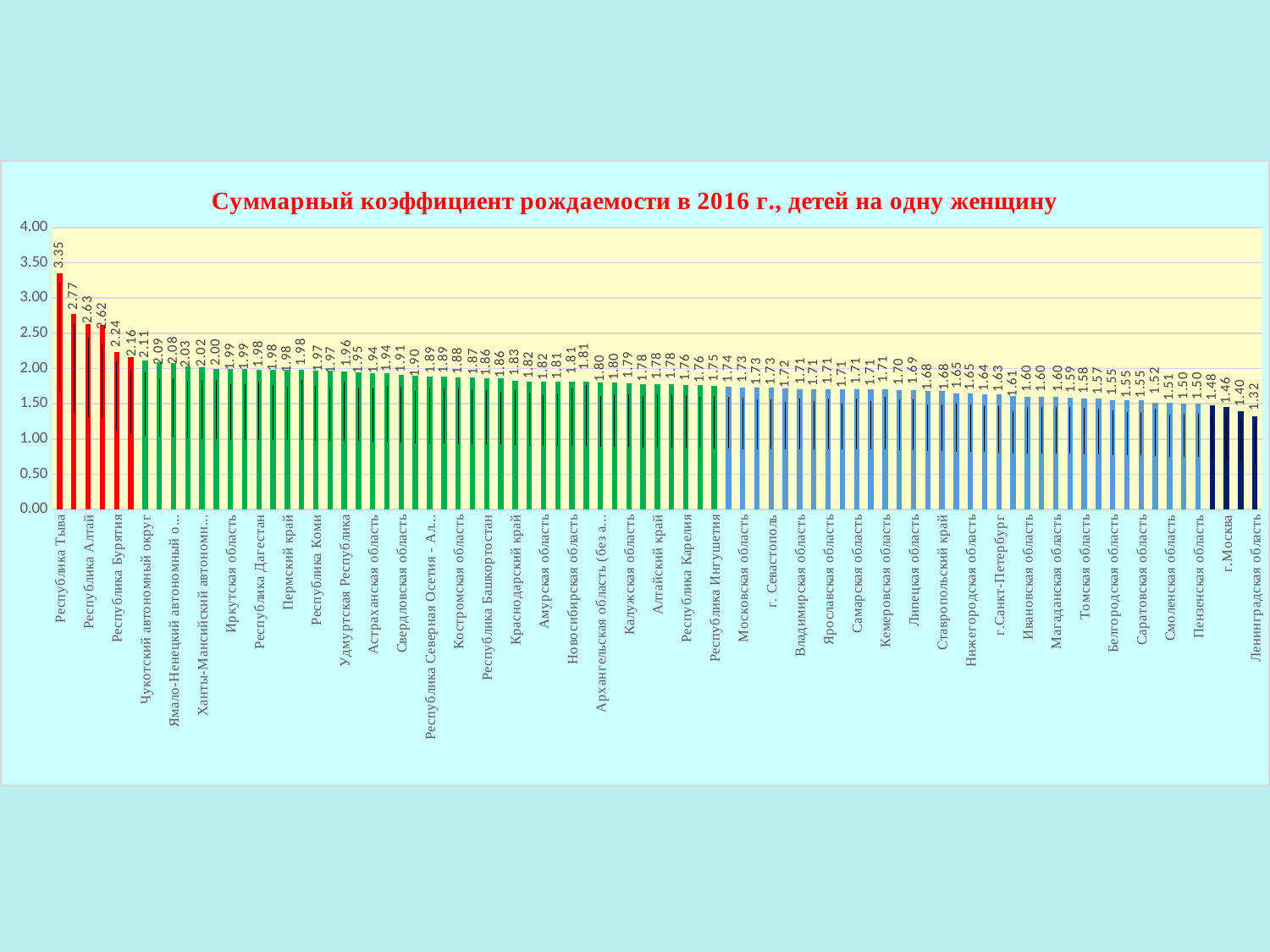
Is the value for Республика Тыва greater or less than 3.00? greater Do the values rise or fall moving from left to right along the x axis? fall Which region has the lowest total fertility rate in the chart? Ленинградская область What colour are the bars for the regions with the highest values on the left of the chart? red Which has a higher value: Республика Тыва or г.Москва? Республика Тыва What is the total fertility rate shown for г.Москва? 1.46 What is the difference between the values for Республика Тыва and Ленинградская область? 2.03 What is the total fertility rate shown for Республика Тыва? 3.35 What is the total fertility rate shown for Ленинградская область? 1.32 What is the title of the chart? Суммарный коэффициент рождаемости в 2016 г., детей на одну женщину What type of chart is shown on the slide? bar chart Which region has the highest total fertility rate in the chart? Республика Тыва